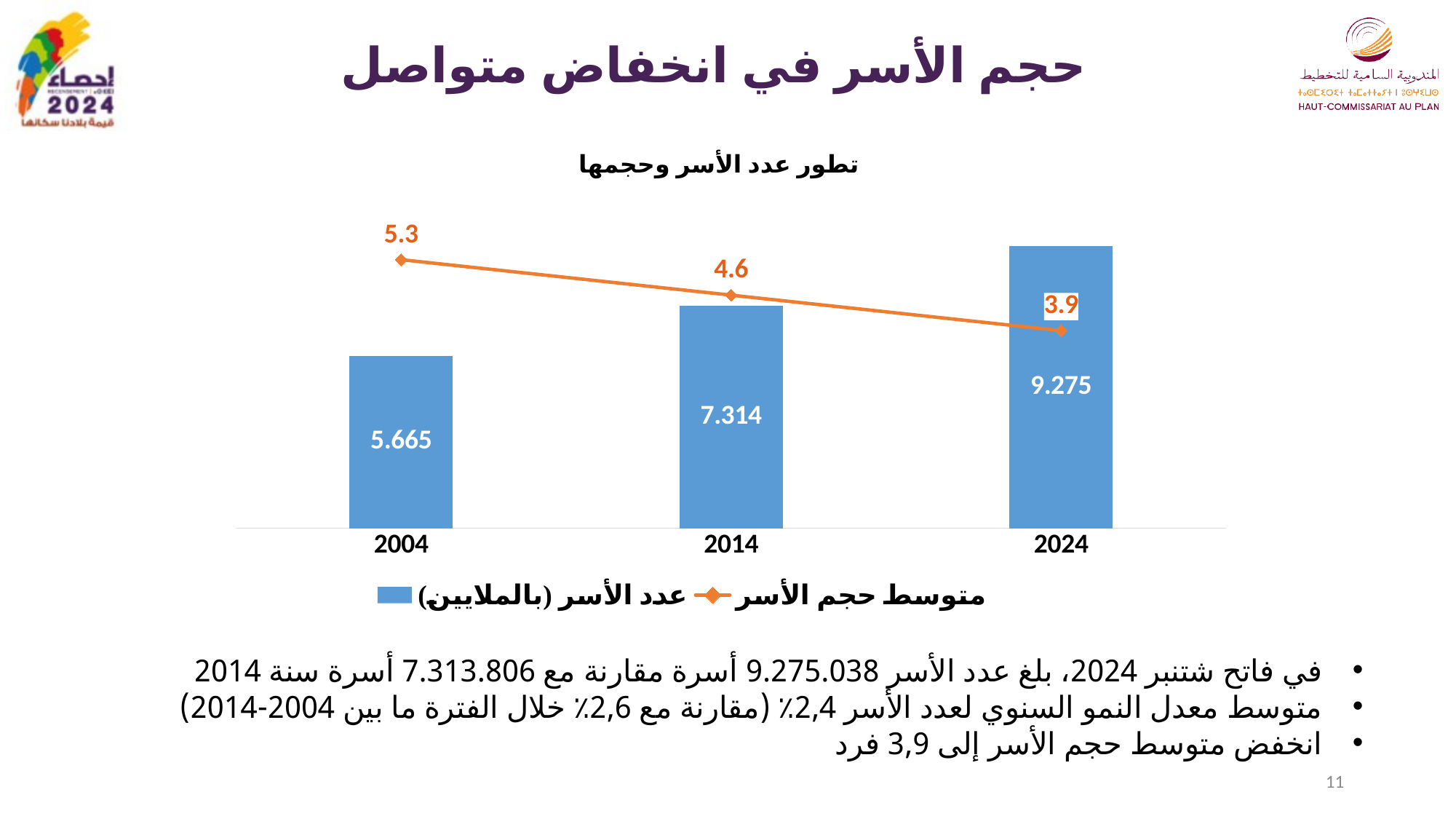
How many years are shown on the x axis of the chart? 3 Is the number of households in 2014 larger or smaller than in 2004? larger What is the average household size (متوسط حجم الأسر) shown for 2014? 4.6 Does the average household size (the orange line) rise or fall from 2004 to 2024? fall What is the difference in the number of households (in millions) between 2024 and 2014? 1.961 What is the average household size (متوسط حجم الأسر) shown for 2024? 3.9 Which year has the highest number of households? 2024 By how much did the average household size fall from 2004 to 2024? 1.4 What is the number of households (in millions) shown for 2004? 5.665 What is the number of households (in millions) shown for 2024? 9.275 How many series does the chart legend list? 2 Which year has the lowest average household size? 2024